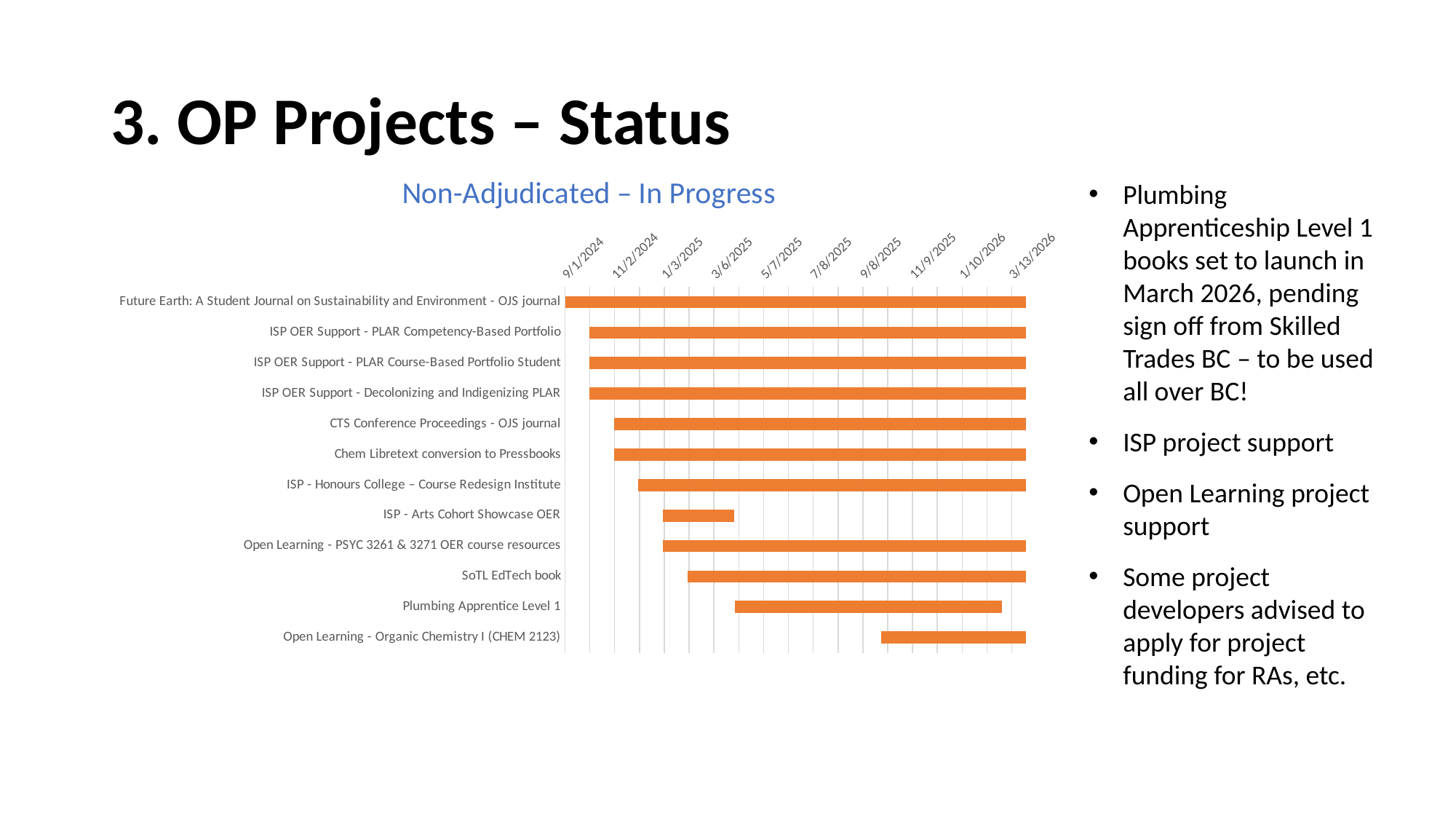
Which bar is longer: SoTL EdTech book or Plumbing Apprentice Level 1? SoTL EdTech book Which project's bar starts latest on the timeline? Open Learning - Organic Chemistry I (CHEM 2123) Does the bar for ISP - Arts Cohort Showcase OER end before or after 5/7/2025? before Which project has the shortest bar on the chart? ISP - Arts Cohort Showcase OER What is the earliest date shown on the chart's date axis? 9/1/2024 How many projects are listed on the chart? 12 Which project has the longest bar on the chart? Future Earth: A Student Journal on Sustainability and Environment - OJS journal Does the bar for Open Learning - Organic Chemistry I (CHEM 2123) start before or after 9/8/2025? after Which bar is longer: ISP - Arts Cohort Showcase OER or Open Learning - PSYC 3261 & 3271 OER course resources? Open Learning - PSYC 3261 & 3271 OER course resources Does the bar for Plumbing Apprentice Level 1 end before or after 3/13/2026? before What kind of chart is shown on the slide? Bar chart What is the title of the chart? Non-Adjudicated – In Progress